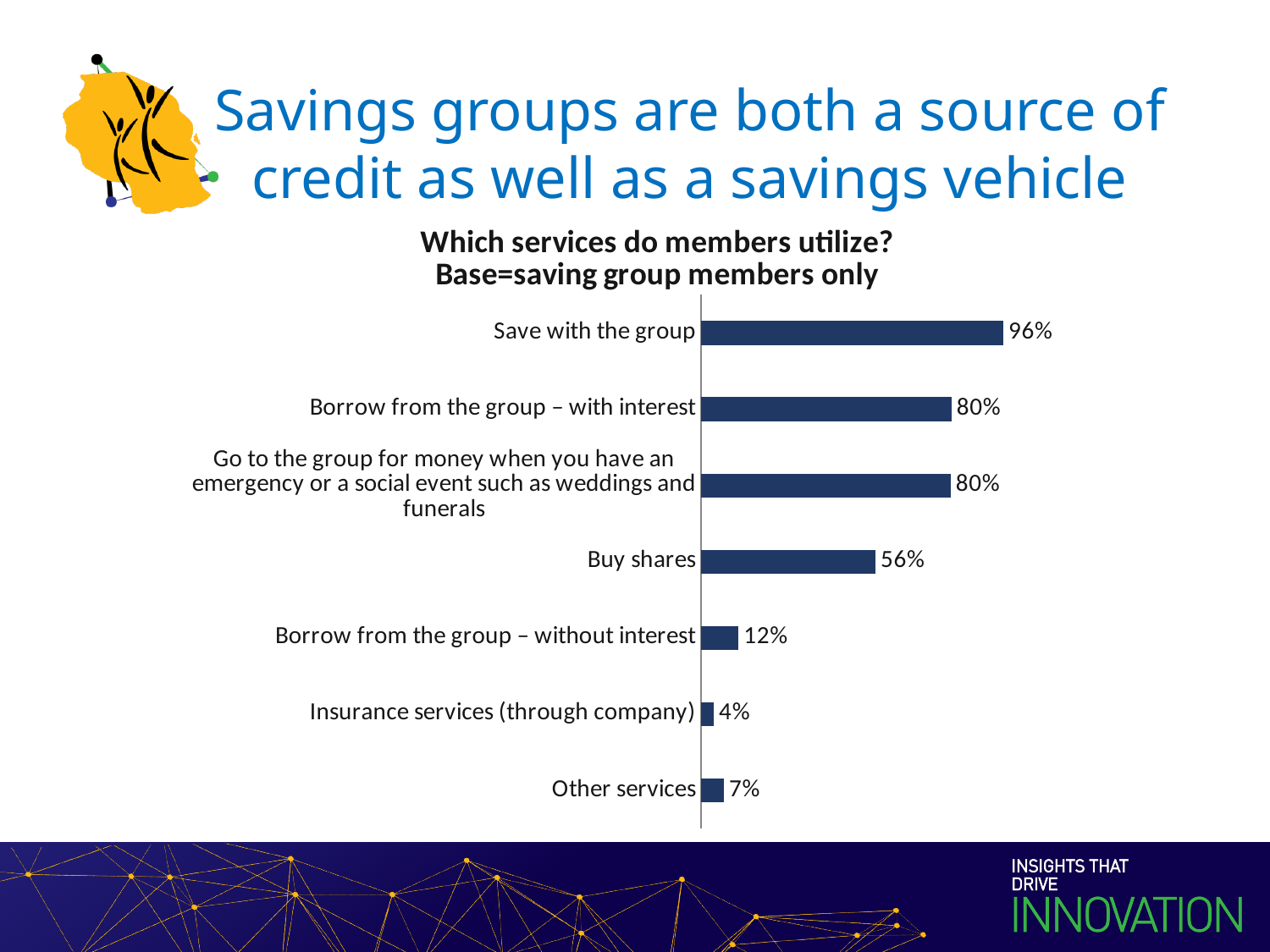
Which is larger: the value for 'Other services' or the value for 'Insurance services (through company)'? Other services What is the difference in percentage points between 'Save with the group' and 'Buy shares'? 40 What percentage of members save with the group? 96% What percentage of members buy shares? 56% What is the title of the chart? Which services do members utilize? Base=saving group members only Which service has the lowest share of members utilizing it? Insurance services (through company) How many service categories are shown in the chart? 7 Which service has the highest share of members utilizing it? Save with the group What percentage of members use insurance services (through company)? 4% What is the difference in percentage points between 'Borrow from the group – with interest' and 'Borrow from the group – without interest'? 68 What kind of chart is shown on the slide? Bar chart What percentage of members borrow from the group without interest? 12%